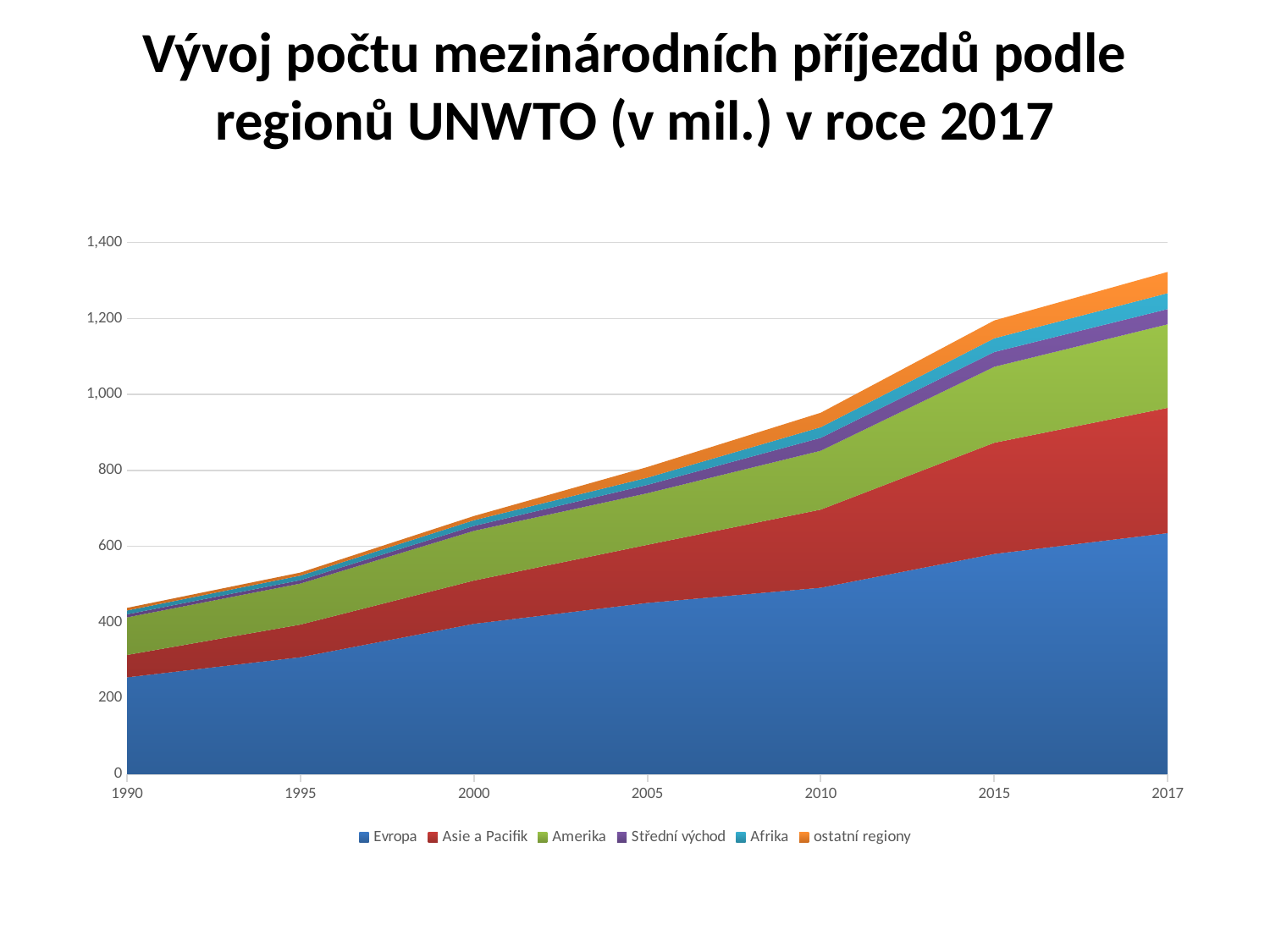
Is the stacked total for 2010 greater or less than 1,000? less Is the value for Evropa in 2017 greater or less than 600? greater In 2017, which is larger: the value for Evropa or the value for Asie a Pacifik? Evropa Is the stacked total for 2017 greater or less than 1,200? greater How many series does the legend list? 6 Which region has the largest band in the chart? Evropa What kind of chart is shown on the slide? stacked area chart What is the first series listed in the legend? Evropa What is the title of the chart? Vývoj počtu mezinárodních příjezdů podle regionů UNWTO (v mil.) v roce 2017 Does the total number of international arrivals rise or fall from 1990 to 2017? rise How many years are marked on the x axis? 7